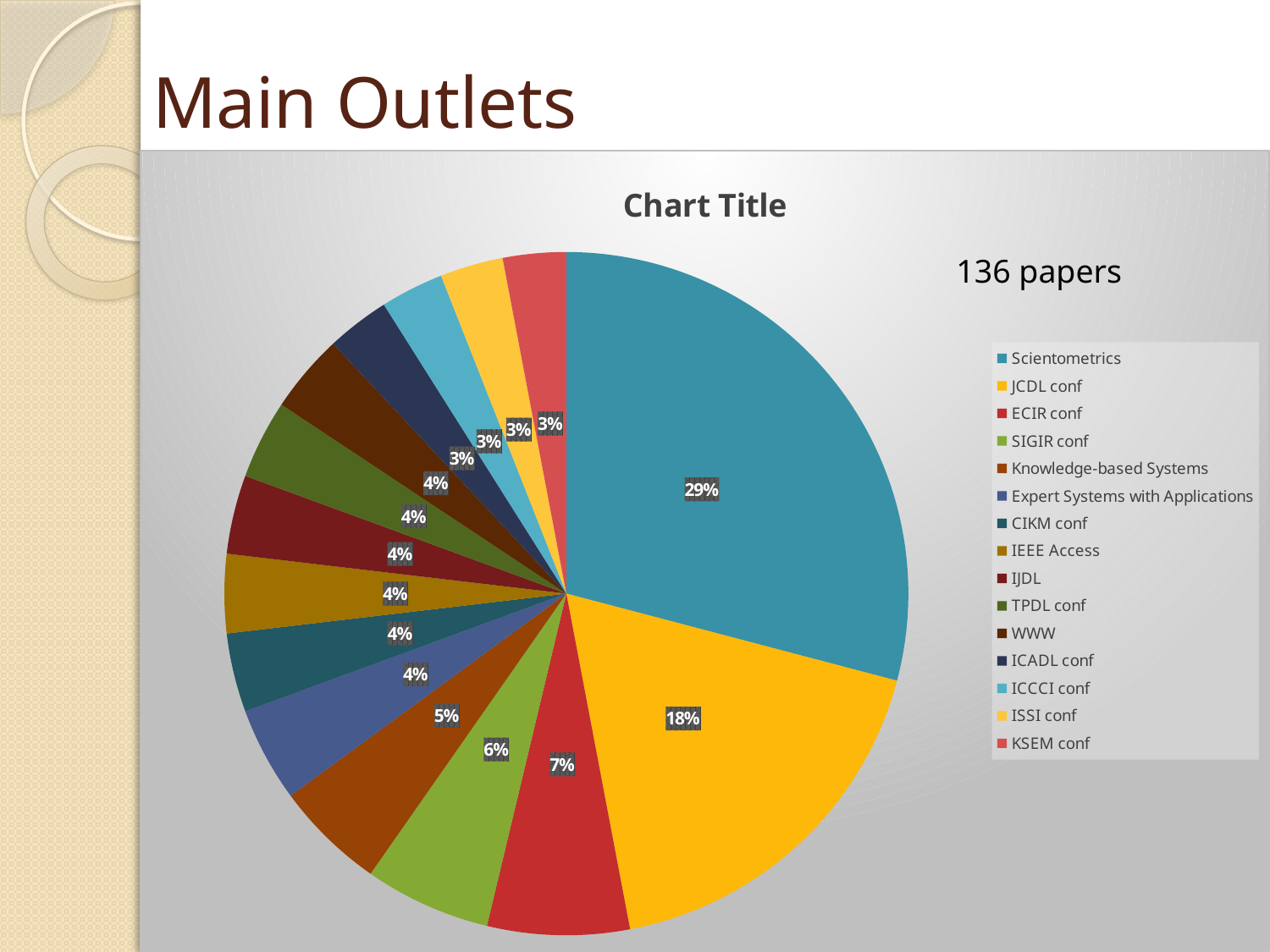
What share of the pie does ECIR conf account for? 7% Which outlet has the largest slice of the pie? Scientometrics How many papers does the slide say the chart covers? 136 papers What type of chart is shown on the slide? pie chart What is the difference in percentage points between the Scientometrics slice and the JCDL conf slice? 11 percentage points How many slices (outlets) does the pie chart have? 15 What share of the pie does SIGIR conf account for? 6% What is the title shown above the pie chart? Chart Title Which slice is larger, ECIR conf or SIGIR conf? ECIR conf What share of the pie does Scientometrics account for? 29%